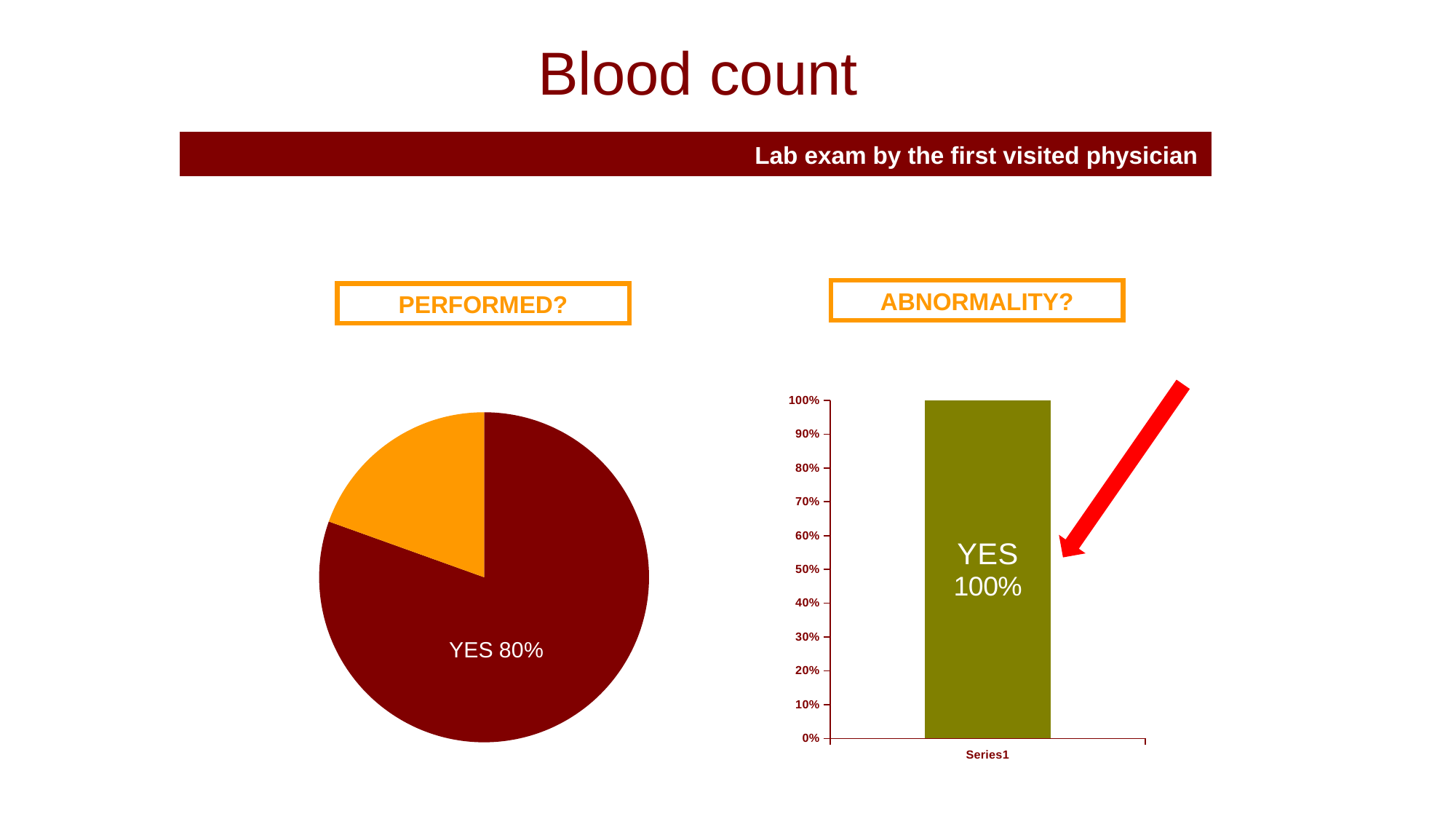
In the ABNORMALITY? bar chart, is the value of the YES bar greater or less than 90%? greater How many bars does the ABNORMALITY? bar chart have? 1 What is the highest tick value shown on the y axis of the ABNORMALITY? bar chart? 100% What kind of chart is shown under the ABNORMALITY? heading? bar chart What colour is the YES slice in the PERFORMED? pie chart? dark red How many slices does the PERFORMED? pie chart have? 2 In the PERFORMED? pie chart, is the YES slice greater or less than half of the pie? greater In the ABNORMALITY? bar chart, what value is labelled on the YES bar? 100% In the PERFORMED? pie chart, which slice is larger, the dark red YES slice or the orange slice? the dark red YES slice In the PERFORMED? pie chart, what share is labelled for the YES slice? 80% What is the category label shown on the x axis of the ABNORMALITY? bar chart? Series1 What kind of chart is shown under the PERFORMED? heading? pie chart